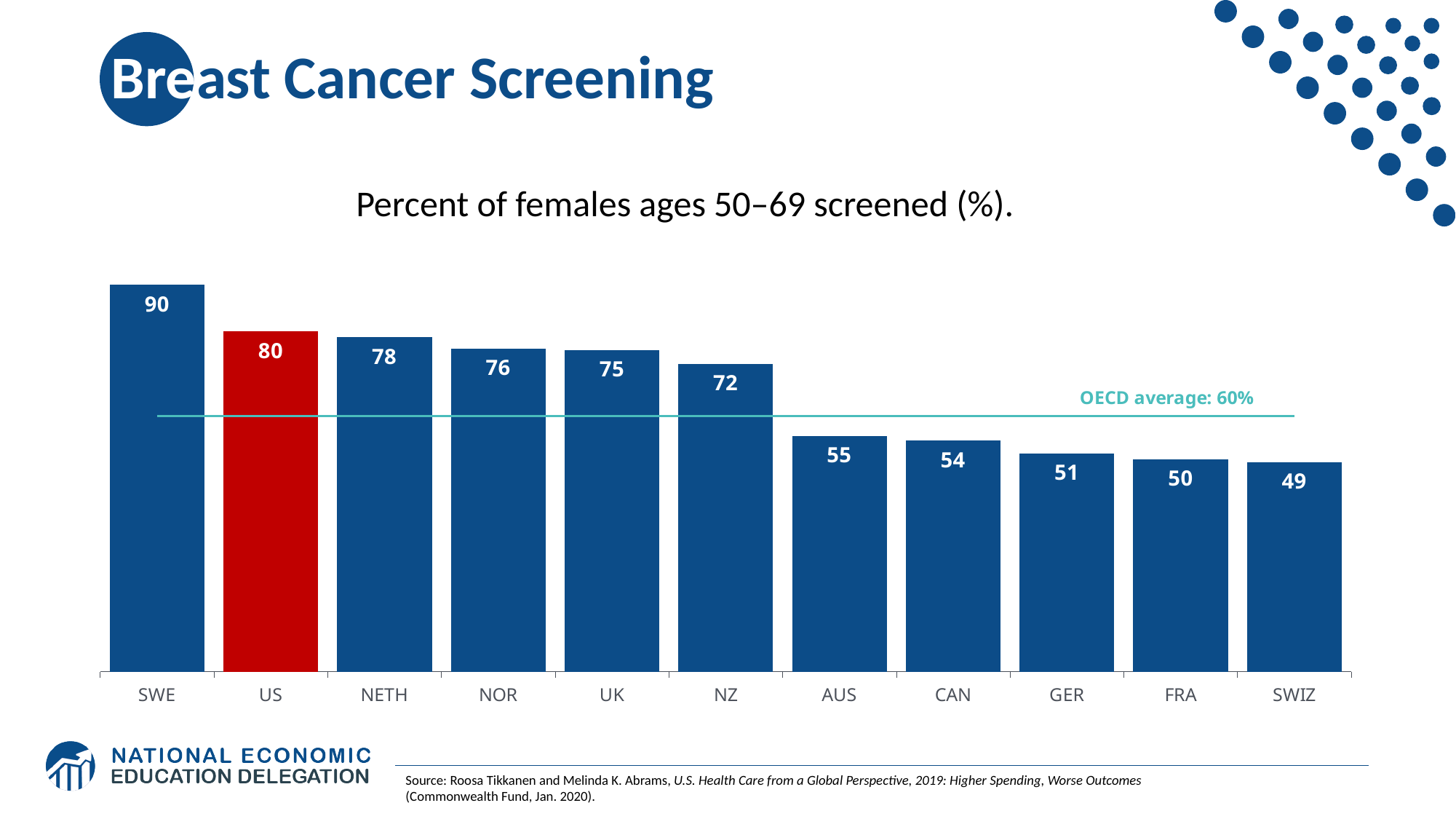
What is the value for the US? 80 What kind of chart is shown on the slide? Bar chart What is the difference between the values for NETH and AUS? 23 What is the value for FRA? 50 What is the difference between the values for SWE and the US? 10 Which country has the highest value? SWE Do the values rise or fall from left to right along the x axis? Fall How many countries are shown on the chart? 11 What OECD average is marked by the horizontal line on the chart? 60% Which country has the lowest value? SWIZ Which is larger, the value for NOR or the value for CAN? NOR What is the value for NZ? 72